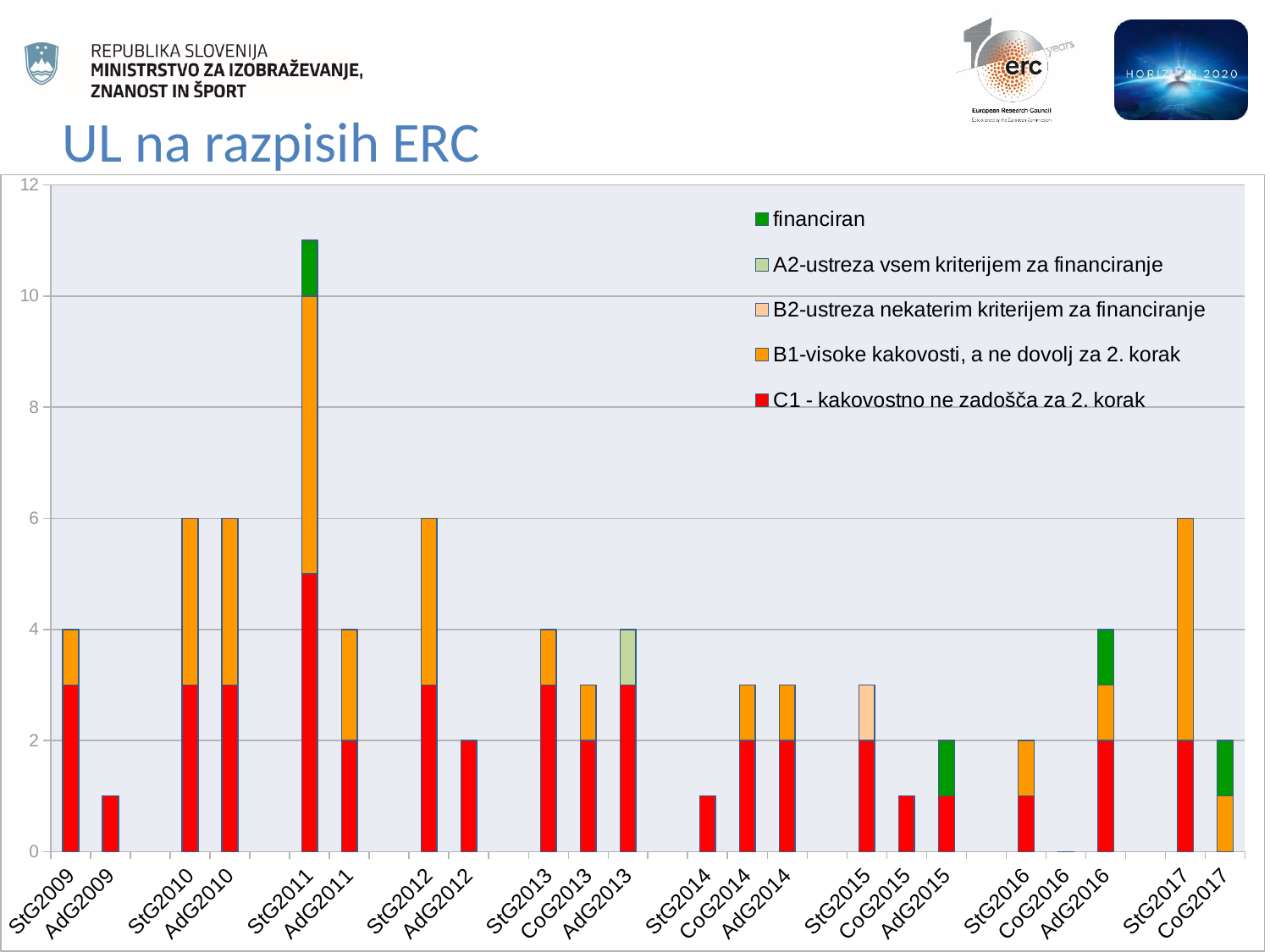
How many series does the legend list? 5 Which legend entry is shown in dark green? financiran What is the total height of the stacked bar for StG2010? 6 Which category has the tallest stacked bar? StG2011 Which category has the lowest stacked bar? CoG2016 What is the title of the chart? UL na razpisih ERC What is the total height of the stacked bar for AdG2011? 4 What kind of chart is shown on the slide? stacked bar chart Which has the larger total, StG2010 or AdG2011? StG2010 What is the total height of the stacked bar for StG2017? 6 How many categories are shown on the x axis? 22 Is the total value for StG2011 greater or less than 10? greater